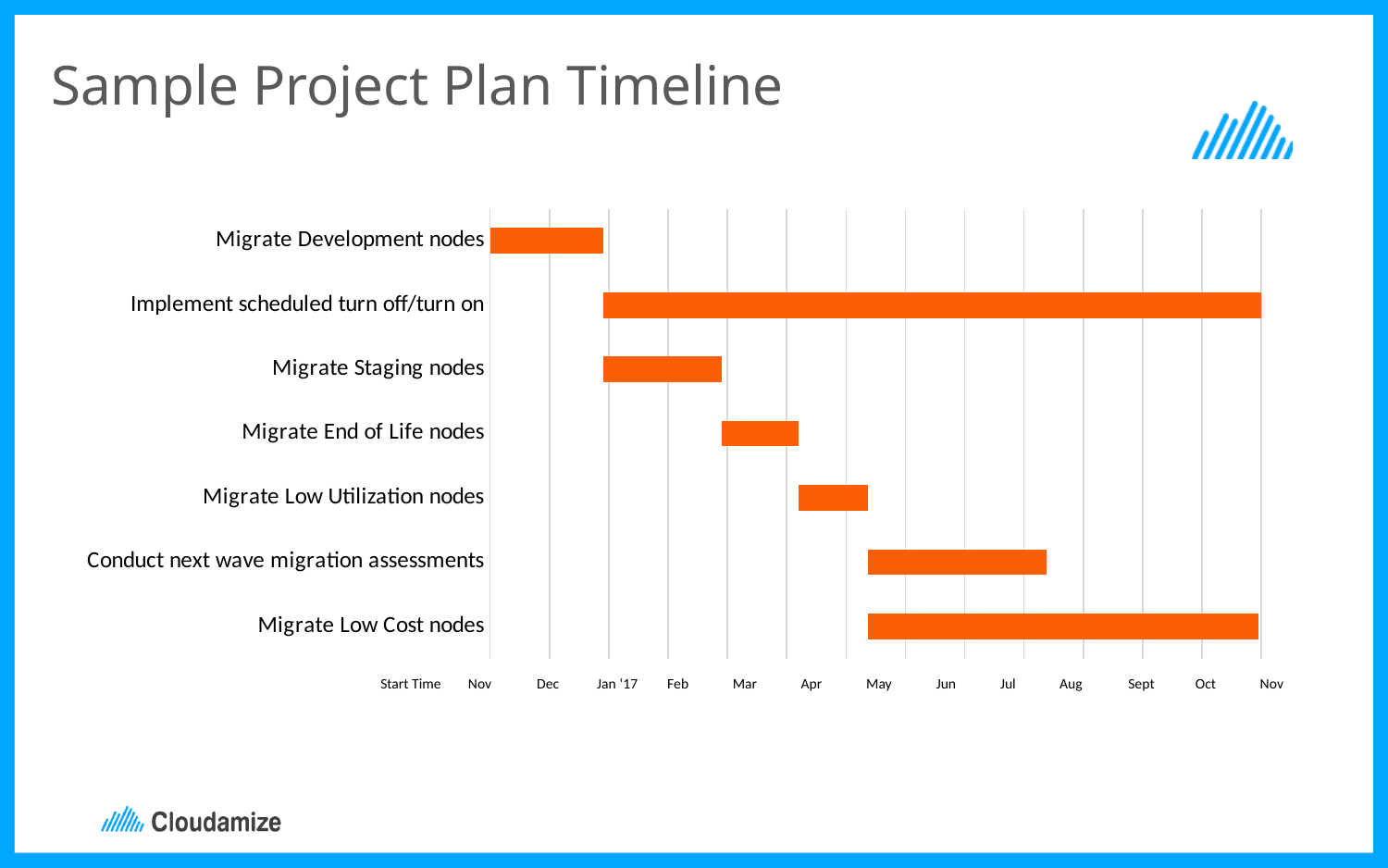
What is the title of the slide containing the chart? Sample Project Plan Timeline Does the bar for 'Migrate Low Cost nodes' extend past Aug? Yes How many tasks are listed on the chart? 7 Does the bar for 'Migrate Development nodes' end before or after Feb? before Which task starts first on the timeline? Migrate Development nodes In which month does the bar for 'Implement scheduled turn off/turn on' begin? Jan '17 What colour are the task bars on the chart? Orange Does the bar for 'Migrate End of Life nodes' start before or after Jan '17? after In which month does the bar for 'Migrate Staging nodes' begin? Jan '17 What kind of chart is shown on the slide? Bar chart (Gantt-style timeline) Which bar is longer: 'Conduct next wave migration assessments' or 'Migrate Low Utilization nodes'? Conduct next wave migration assessments Which task has the longest bar on the timeline? Implement scheduled turn off/turn on